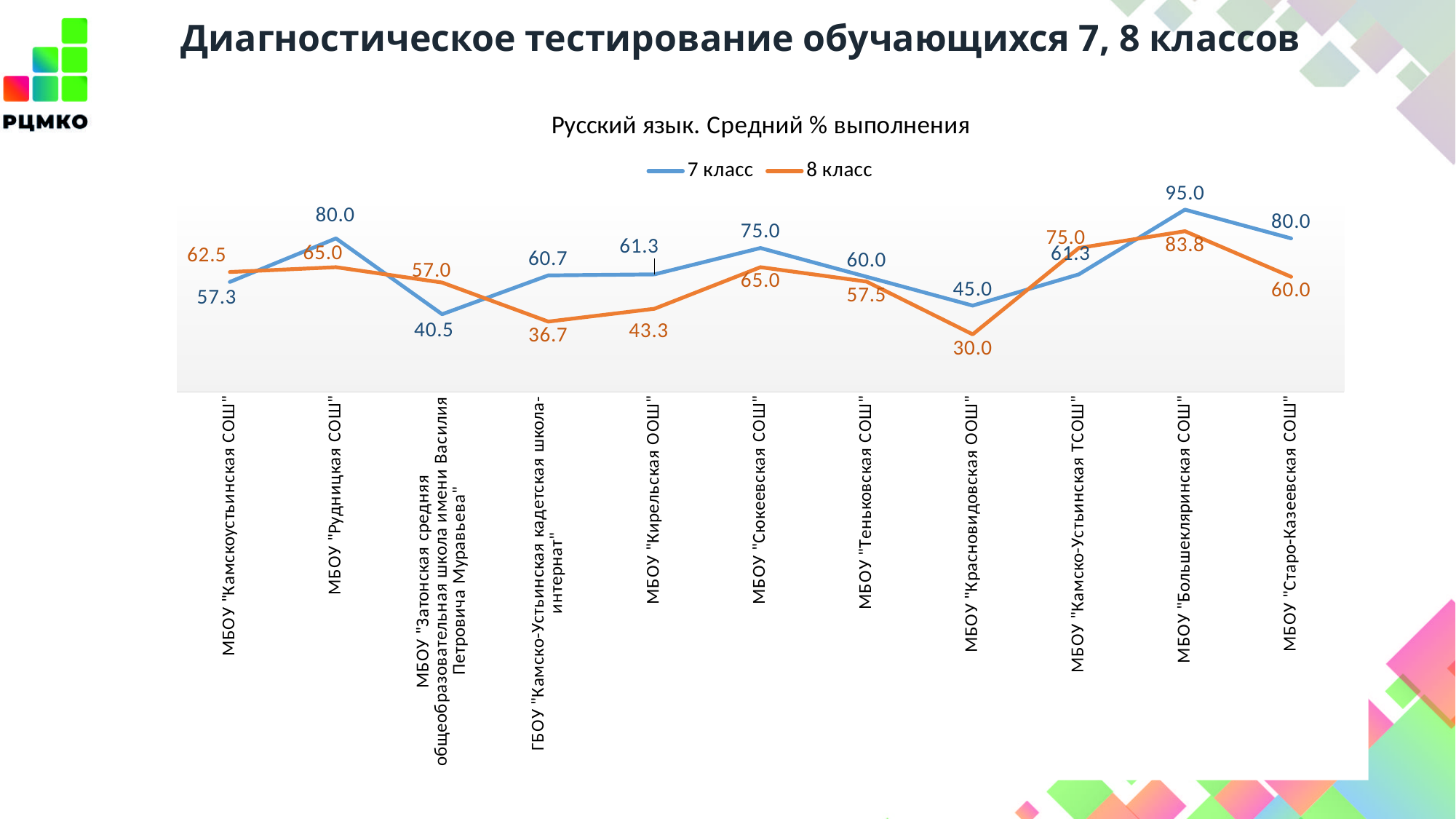
For МБОУ "Камско-Устьинская ТСОШ", which is larger: the 7 класс value or the 8 класс value? 8 класс Which school has the lowest 7 класс value? МБОУ "Затонская средняя общеобразовательная школа имени Василия Петровича Муравьева" What is the 8 класс value for ГБОУ "Камско-Устьинская кадетская школа-интернат"? 36.7 What is the 8 класс value for МБОУ "Красновидовская ООШ"? 30.0 Which school has the highest 7 класс value? МБОУ "Большекляринская СОШ" Which school has the lowest 8 класс value? МБОУ "Красновидовская ООШ" What is the title of the chart? Русский язык. Средний % выполнения How many schools (categories) are plotted on the x axis? 11 What is the 7 класс value for МБОУ "Большекляринская СОШ"? 95.0 How many series does the legend list? 2 What type of chart is shown on the slide? line chart What is the difference between the 7 класс and 8 класс values for МБОУ "Старо-Казеевская СОШ"? 20.0